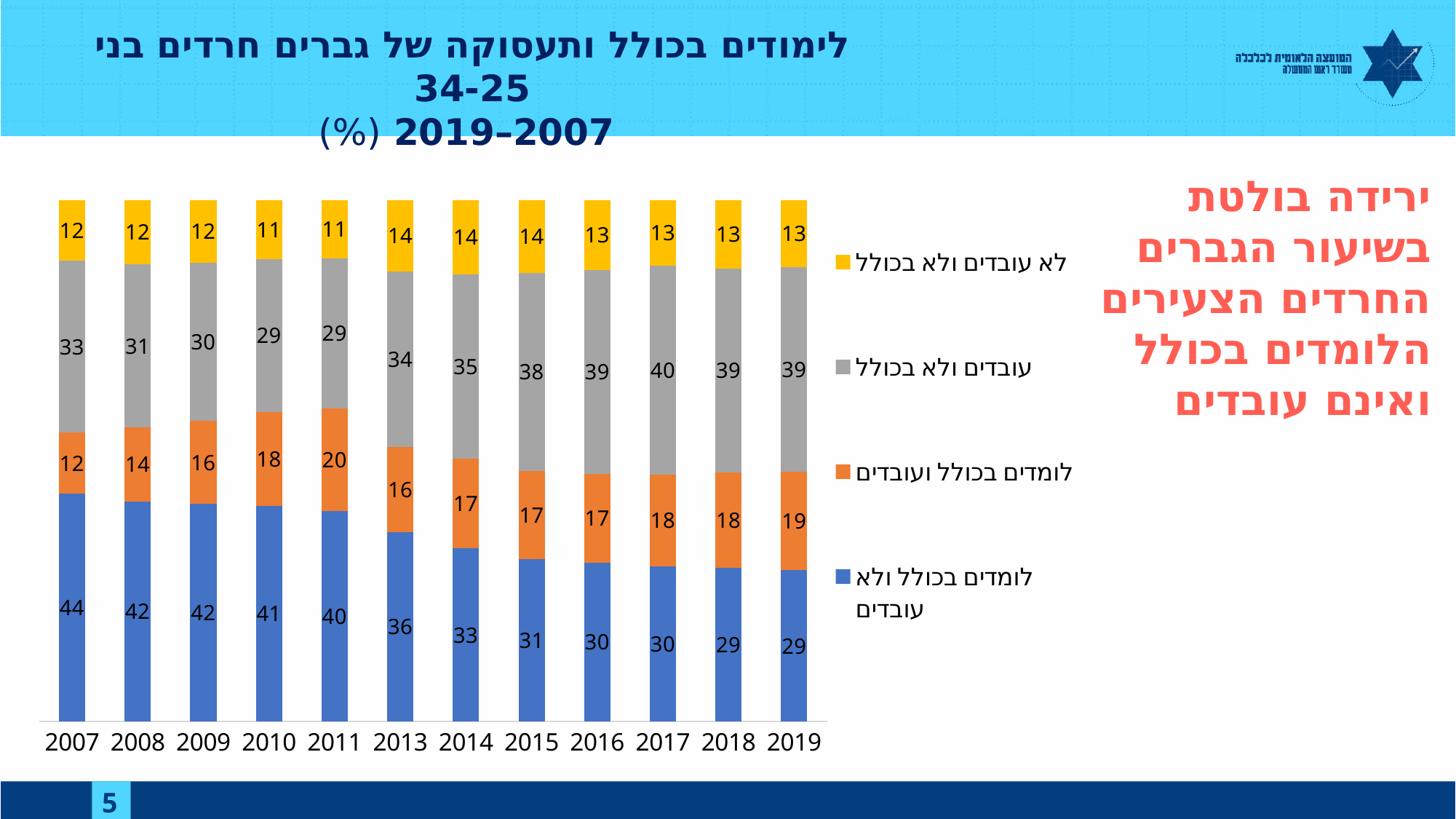
What is the value for 'לומדים בכולל ועובדים' in 2011? 20 What is the value for 'עובדים ולא בכולל' in 2019? 39 In which year is the 'עובדים ולא בכולל' series highest? 2017 What is the difference between the 'לומדים בכולל ולא עובדים' values for 2007 and 2019? 15 In which year is the 'לומדים בכולל ולא עובדים' series highest? 2007 Does the 'לומדים בכולל ולא עובדים' series rise or fall from 2007 to 2019? Fall What is the value for 'לומדים בכולל ולא עובדים' in 2007? 44 What kind of chart is shown on the slide? Stacked bar chart What is the value for 'לא עובדים ולא בכולל' in 2015? 14 Which is larger in 2014: 'לומדים בכולל ולא עובדים' or 'עובדים ולא בכולל'? עובדים ולא בכולל How many years are shown on the x axis? 12 How many series does the legend list? 4